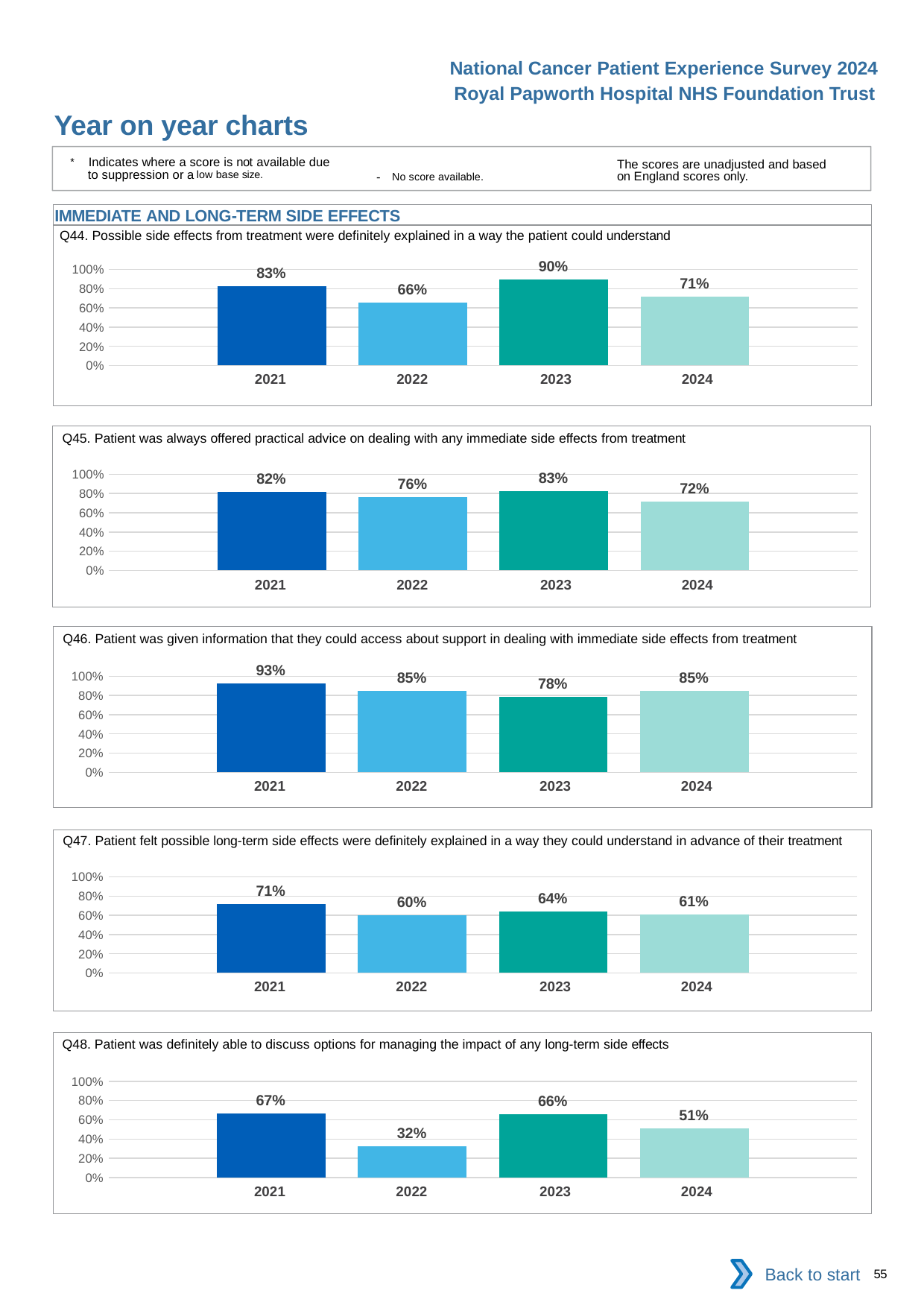
In the Q48 chart, what is the value for 2022? 32% In the Q46 chart, what is the value for 2024? 85% In the Q46 chart, what is the difference between the 2021 and 2023 values? 15% In the Q45 chart, which year has the lowest value? 2024 What kind of chart is the Q45 chart? bar chart In the Q47 chart, what is the difference between the 2021 and 2022 values? 11% How many charts are shown on the slide? 5 In the Q48 chart, which is larger, the value for 2021 or the value for 2024? 2021 In the Q44 chart, how many years are plotted? 4 In the Q44 chart, is the value for 2022 greater or less than 80%? less In the Q47 chart, which year has the highest value? 2021 In the Q44 chart, what is the value for 2023? 90%